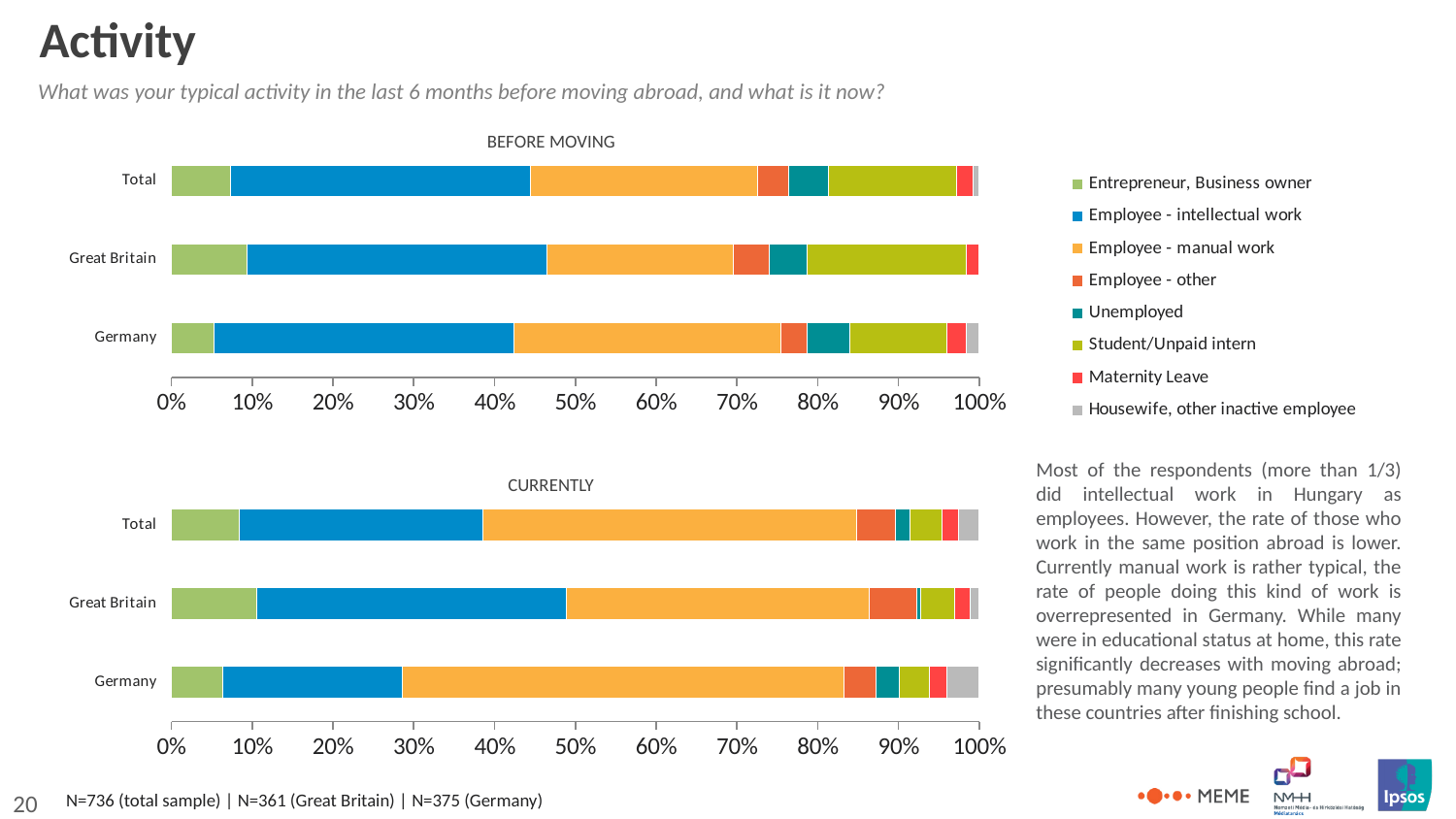
In the CURRENTLY chart, which has the larger Employee - intellectual work share, Great Britain or Germany? Great Britain How many series does the legend list? 8 In the BEFORE MOVING chart, is the Employee - intellectual work share for Total greater or less than 30%? greater Which legend entry is shown in blue? Employee - intellectual work In the CURRENTLY chart, is the Employee - manual work share for Germany greater or less than 40%? greater In the BEFORE MOVING chart, which has the larger Entrepreneur, Business owner share, Great Britain or Germany? Great Britain What is the title of the upper chart? BEFORE MOVING In the CURRENTLY chart, which has the larger Employee - manual work share, Great Britain or Germany? Germany What kind of chart is the BEFORE MOVING chart? Stacked bar chart How many categories (bars) does the CURRENTLY chart show? 3 In the CURRENTLY chart, is the Employee - intellectual work share for Germany greater or less than 30%? less